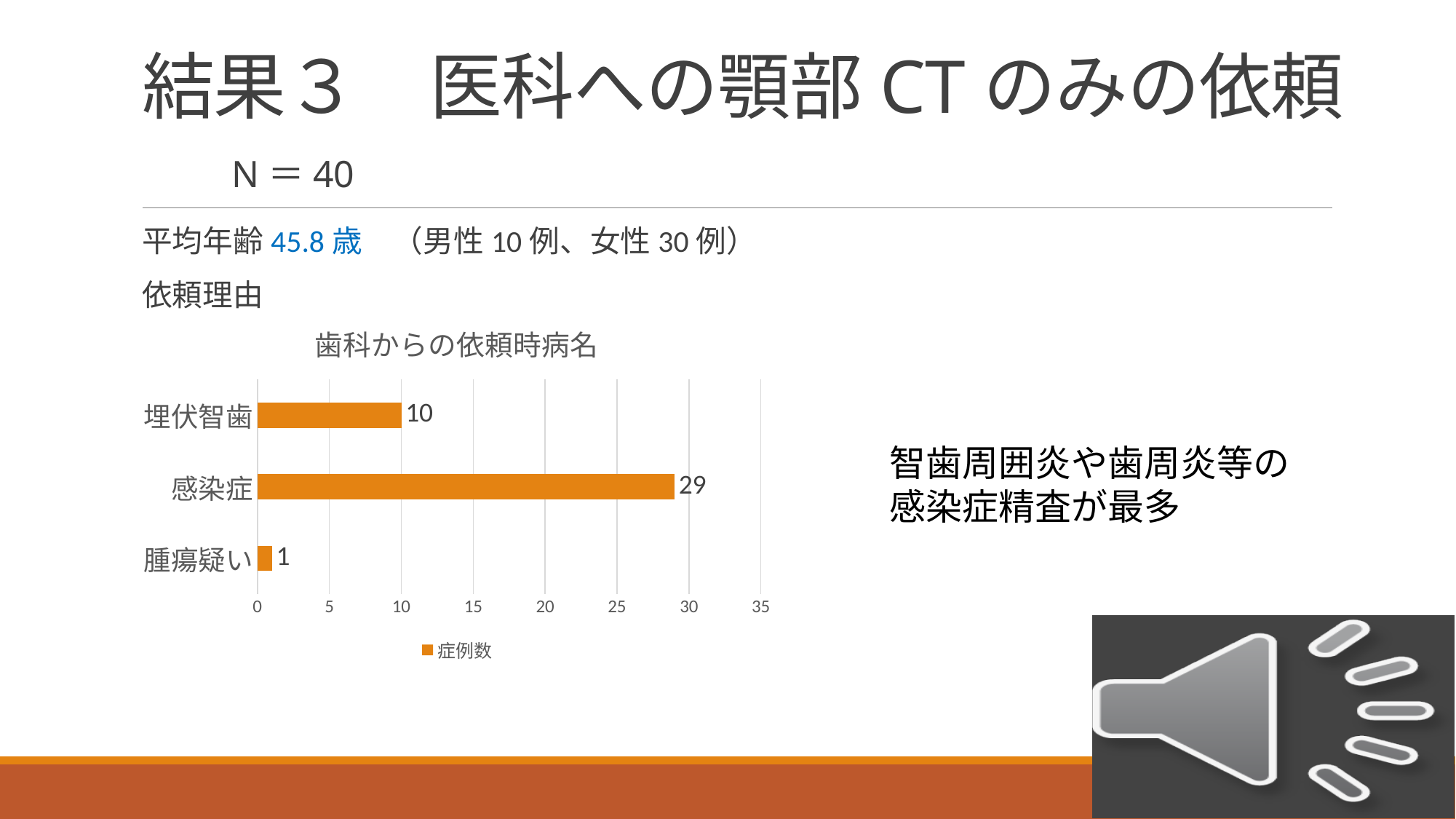
What is the value for 埋伏智歯? 10 What is the difference between the values for 感染症 and 埋伏智歯? 19 How many categories are shown in the chart? 3 What is the title of the chart? 歯科からの依頼時病名 Which category has the lowest value? 腫瘍疑い What is the value for 感染症? 29 What kind of chart is shown on the slide? bar chart Which is larger, the value for 埋伏智歯 or the value for 腫瘍疑い? 埋伏智歯 How many series does the legend list? 1 Which category has the highest value? 感染症 What is the value for 腫瘍疑い? 1 Is the value for 感染症 greater or less than 25? greater